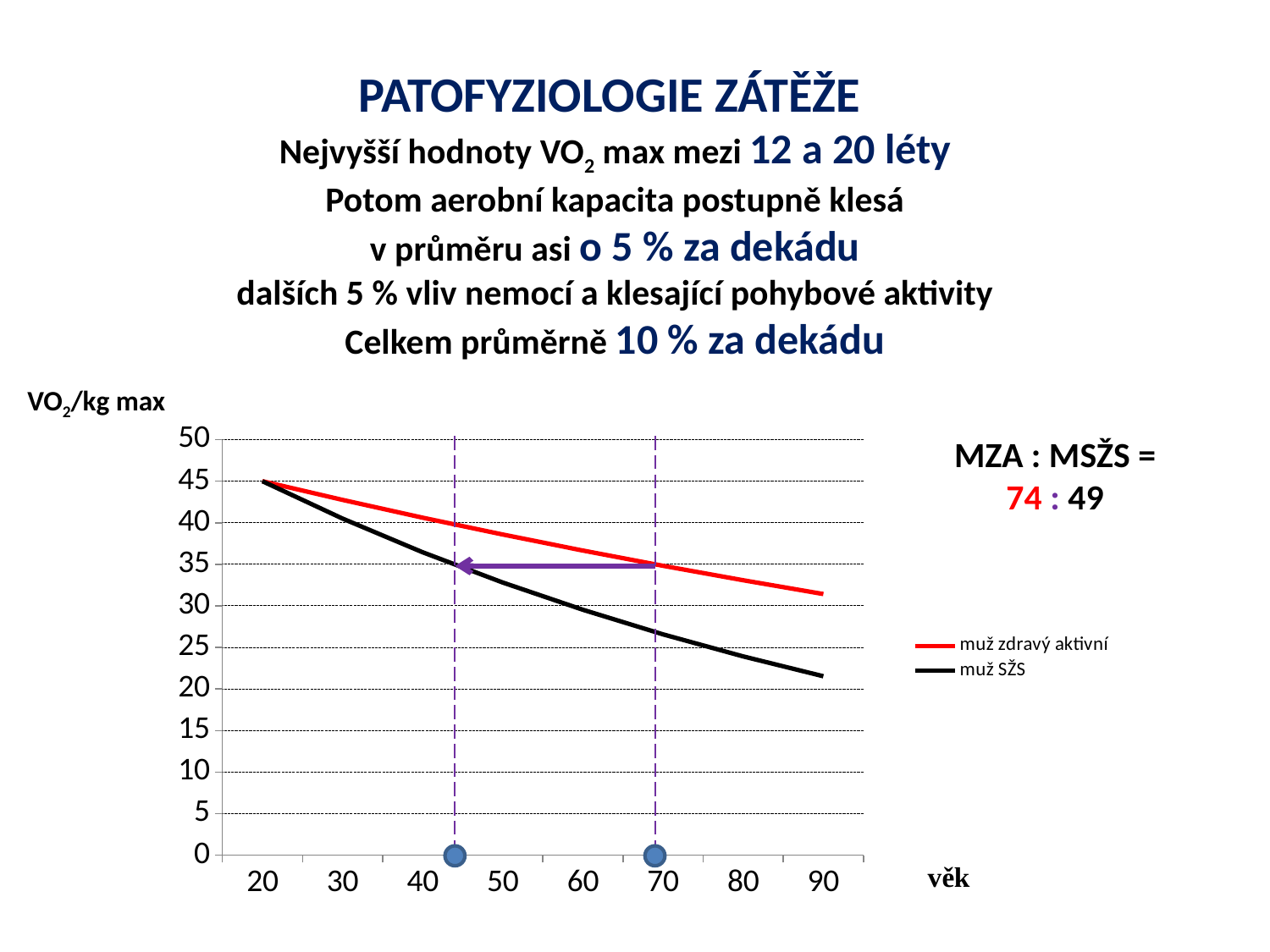
Is the value of 'muž SŽS' at age 50 greater or less than 35? less Is the value of 'muž zdravý aktivní' at age 90 greater or less than 30? greater Is the value of 'muž zdravý aktivní' at age 60 greater or less than 35? greater What is the highest age shown on the x axis of the chart? 90 How many series does the chart legend list? 2 At age 90, which series has the higher value, 'muž zdravý aktivní' or 'muž SŽS'? muž zdravý aktivní Do the values of both lines rise or fall as age (věk) increases? fall Which colour is used for the 'muž SŽS' line? black What is the VO2/kg max value of both lines at age 20? 45 What are the two series named in the chart legend? muž zdravý aktivní, muž SŽS What kind of chart is shown on the slide? line chart